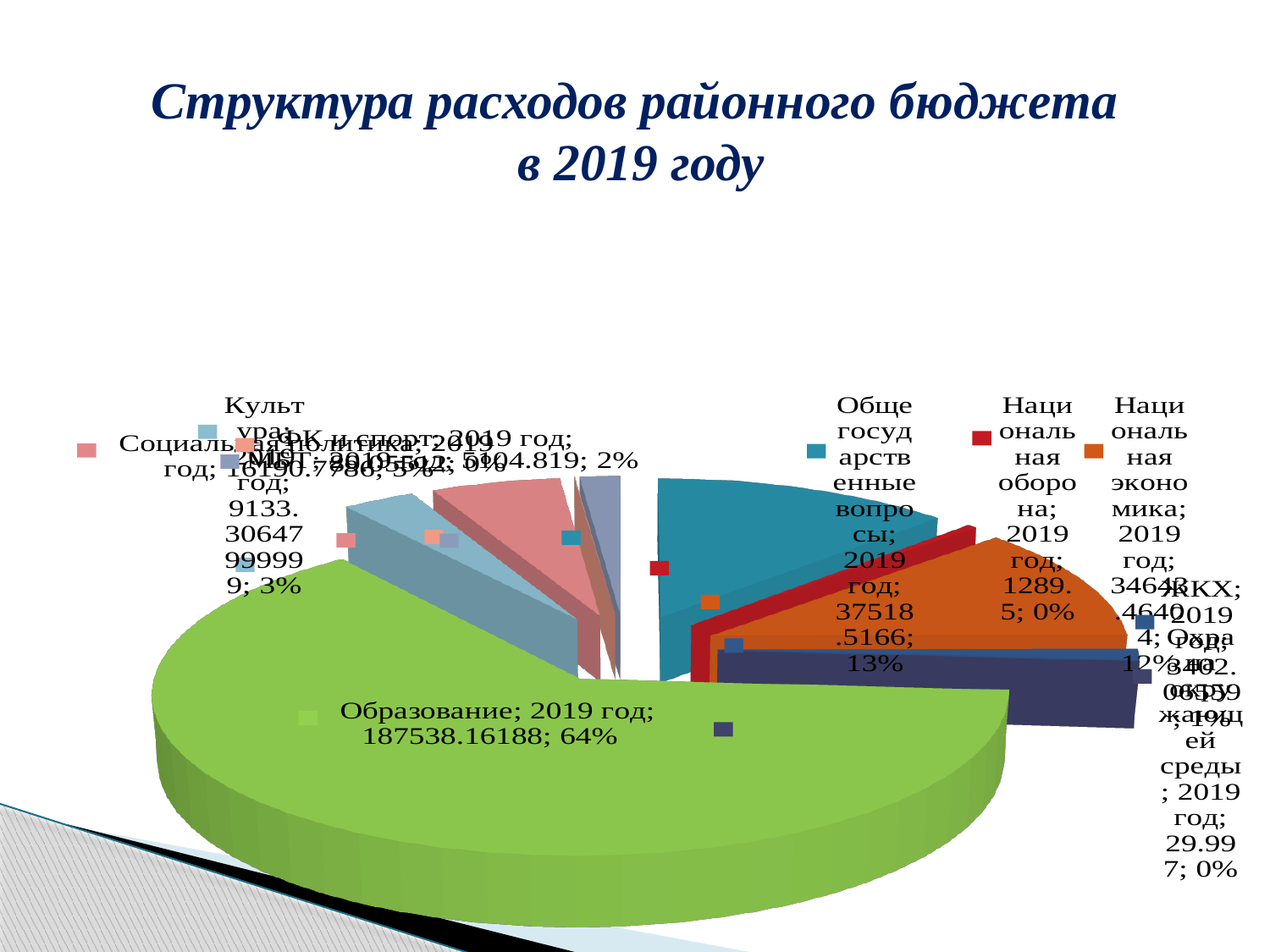
What share of the pie does Общегосударственные вопросы take? 13% What is the value shown for Общегосударственные вопросы? 37518.5166 What share of the pie does Образование take? 64% What is the value shown for Национальная оборона? 1289.5 What is the title of the chart on the slide? Структура расходов районного бюджета в 2019 году What kind of chart is shown on the slide? pie chart What is the value shown for Охрана окружающей среды? 29.997 Which category has the largest slice of the pie? Образование What share of the pie does Культура take? 3% What is the value shown for Образование? 187538.16188 Which is larger, the slice for Образование or the slice for Общегосударственные вопросы? Образование What is the value shown for ФК и спорт? 89.055